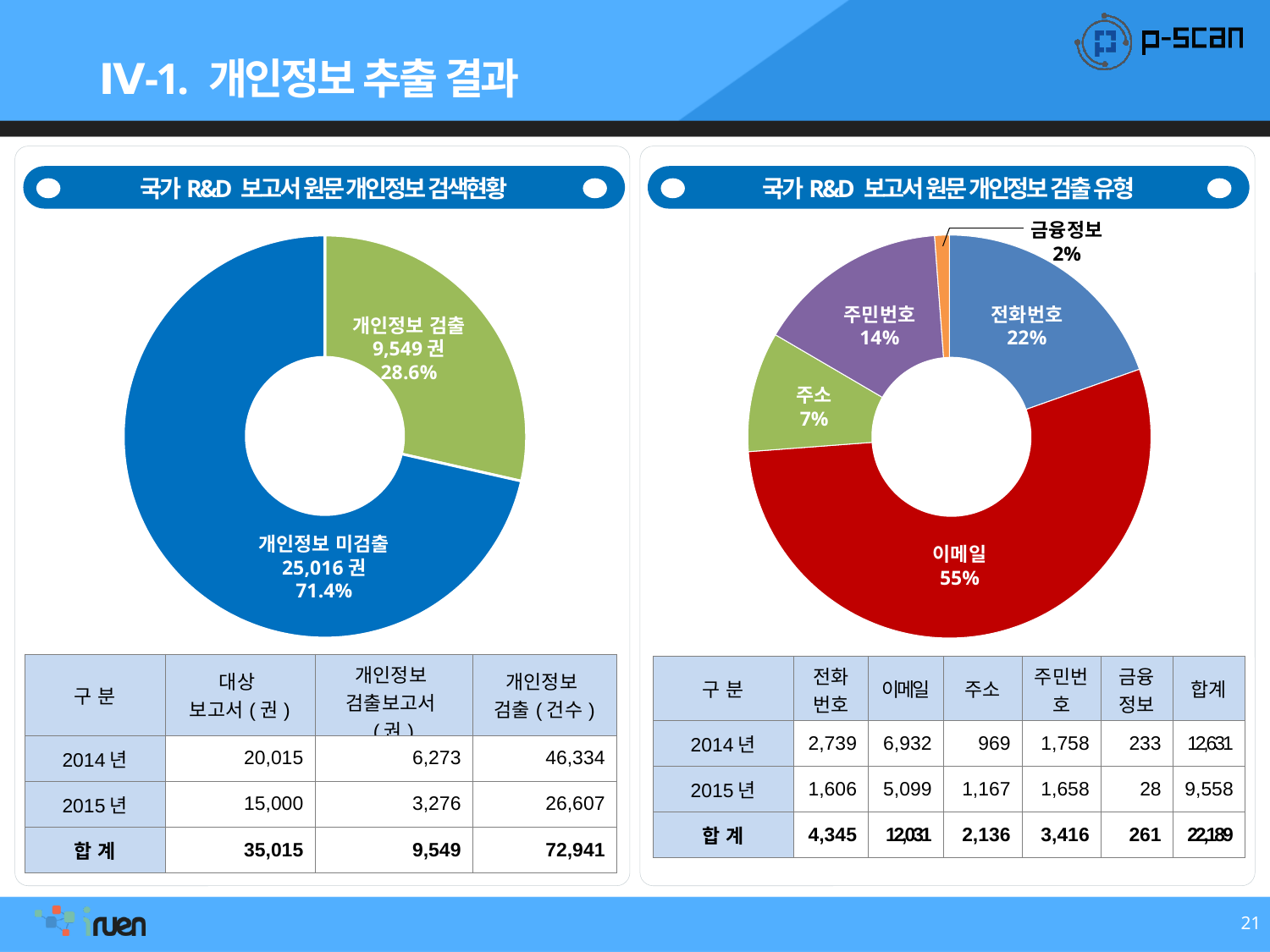
In the right chart (국가 R&D 보고서 원문 개인정보 검출 유형), what share does 이메일 have? 55% In the left chart (국가 R&D 보고서 원문 개인정보 검색현황), what is the difference in 권 between 개인정보 미검출 and 개인정보 검출? 15,467 권 How many categories are shown in the right chart (국가 R&D 보고서 원문 개인정보 검출 유형)? 5 In the right chart (국가 R&D 보고서 원문 개인정보 검출 유형), which category has the smallest share? 금융정보 In the left chart (국가 R&D 보고서 원문 개인정보 검색현황), how many 권 are shown for 개인정보 미검출? 25,016 권 In the left chart (국가 R&D 보고서 원문 개인정보 검색현황), what percentage is shown for 개인정보 검출? 28.6% How many segments does the left chart (국가 R&D 보고서 원문 개인정보 검색현황) have? 2 In the right chart (국가 R&D 보고서 원문 개인정보 검출 유형), what is the difference in percentage points between 전화번호 and 주소? 15 percentage points In the left chart (국가 R&D 보고서 원문 개인정보 검색현황), which segment is larger, 개인정보 검출 or 개인정보 미검출? 개인정보 미검출 What type of chart is the right chart (국가 R&D 보고서 원문 개인정보 검출 유형)? Donut (pie) chart In the right chart (국가 R&D 보고서 원문 개인정보 검출 유형), which category has the largest share? 이메일 In the right chart (국가 R&D 보고서 원문 개인정보 검출 유형), what percentage is shown for 주민번호? 14%